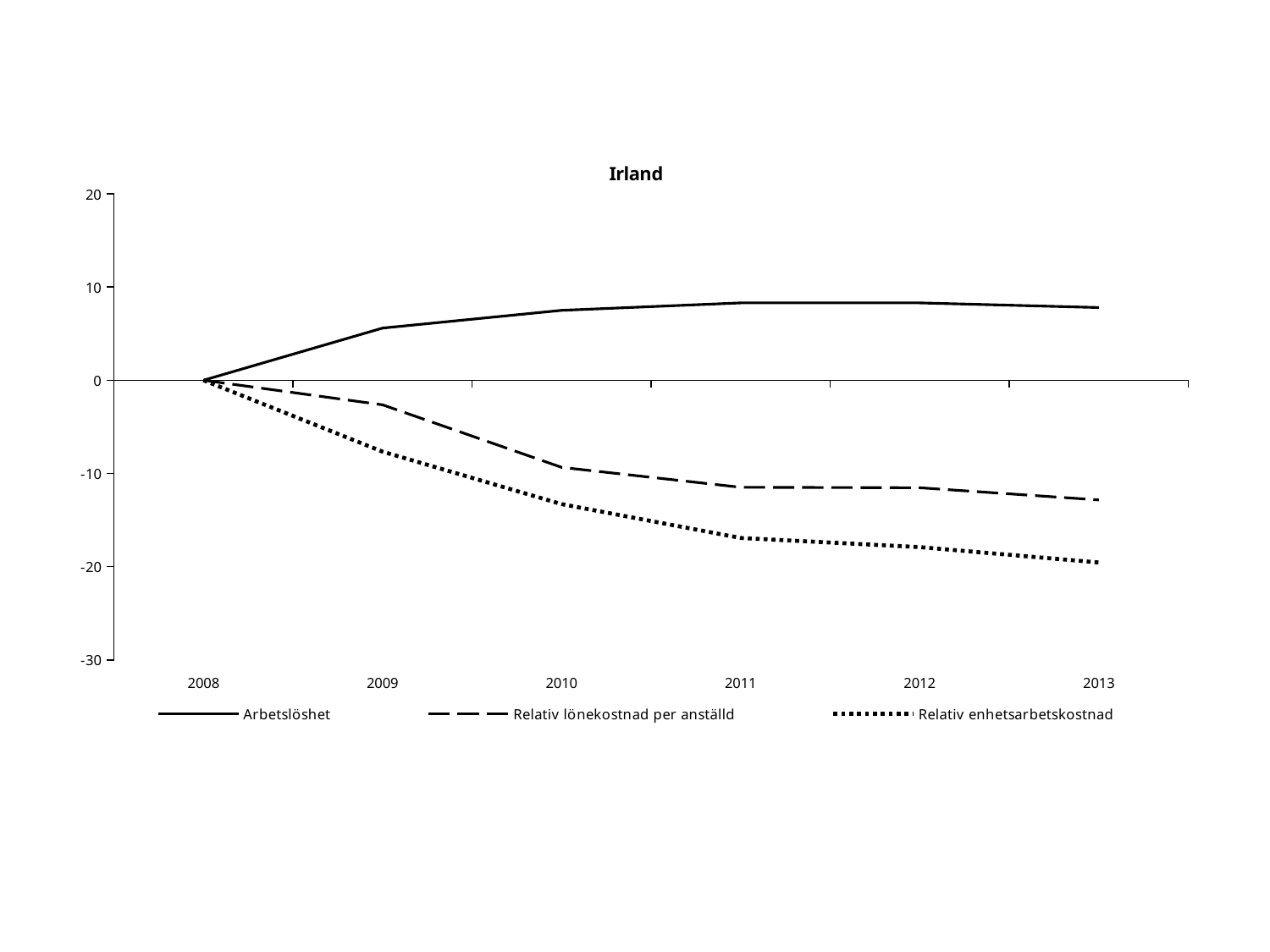
Is the value for Relativ lönekostnad per anställd in 2010 greater or less than 0? less How many years are shown on the x axis? 6 What is the title of the chart? Irland Does the Arbetslöshet line rise or fall from 2008 to 2011? rise How many series does the legend list? 3 What kind of chart is shown on the slide? line chart Does the Relativ enhetsarbetskostnad line rise or fall from 2008 to 2013? fall Is the value for Relativ enhetsarbetskostnad in 2013 greater or less than -10? less Is the value for Arbetslöshet in 2013 greater or less than 10? less Which series has the lowest value in 2013? Relativ enhetsarbetskostnad What is the value of Arbetslöshet in 2008? 0 In 2013, which is larger: Relativ lönekostnad per anställd or Relativ enhetsarbetskostnad? Relativ lönekostnad per anställd